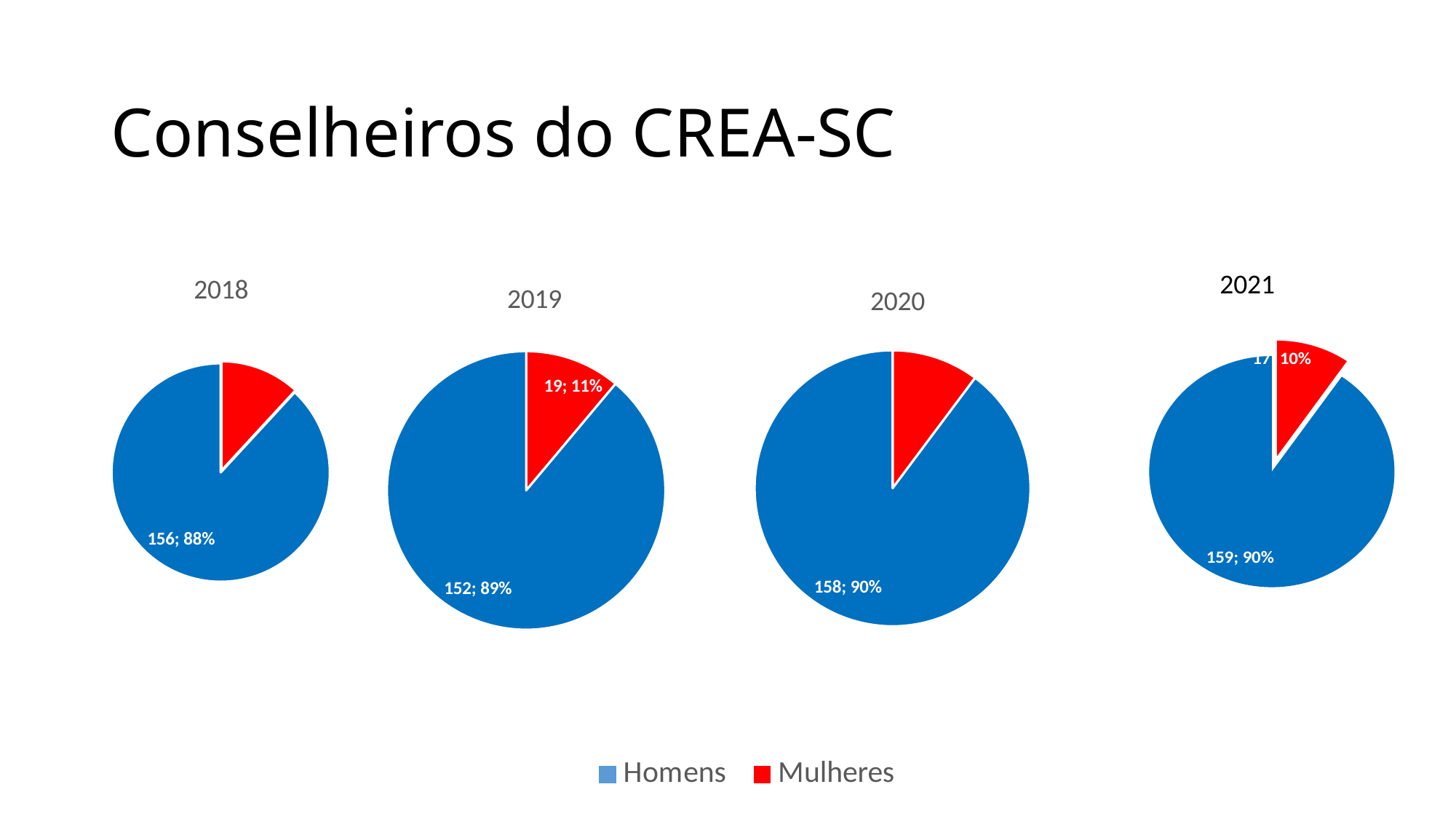
According to the legend, which colour represents Mulheres? Red In the 2019 pie chart, what is the data label for Homens? 152; 89% In the 2020 pie chart, what is the data label for Homens? 158; 90% How many series does the legend list? 2 In the 2018 pie chart, what is the data label for Homens? 156; 88% In the 2019 pie chart, which is larger, Homens or Mulheres? Homens In the 2019 pie chart, what is the data label for Mulheres? 19; 11% What kind of charts are shown on the slide? Pie charts In the 2019 pie chart, what is the difference between the Homens count and the Mulheres count? 133 How many pie charts are on the slide? 4 In the 2021 pie chart, what is the data label for Homens? 159; 90% In the 2019 pie chart, what share of the pie is Mulheres? 11%